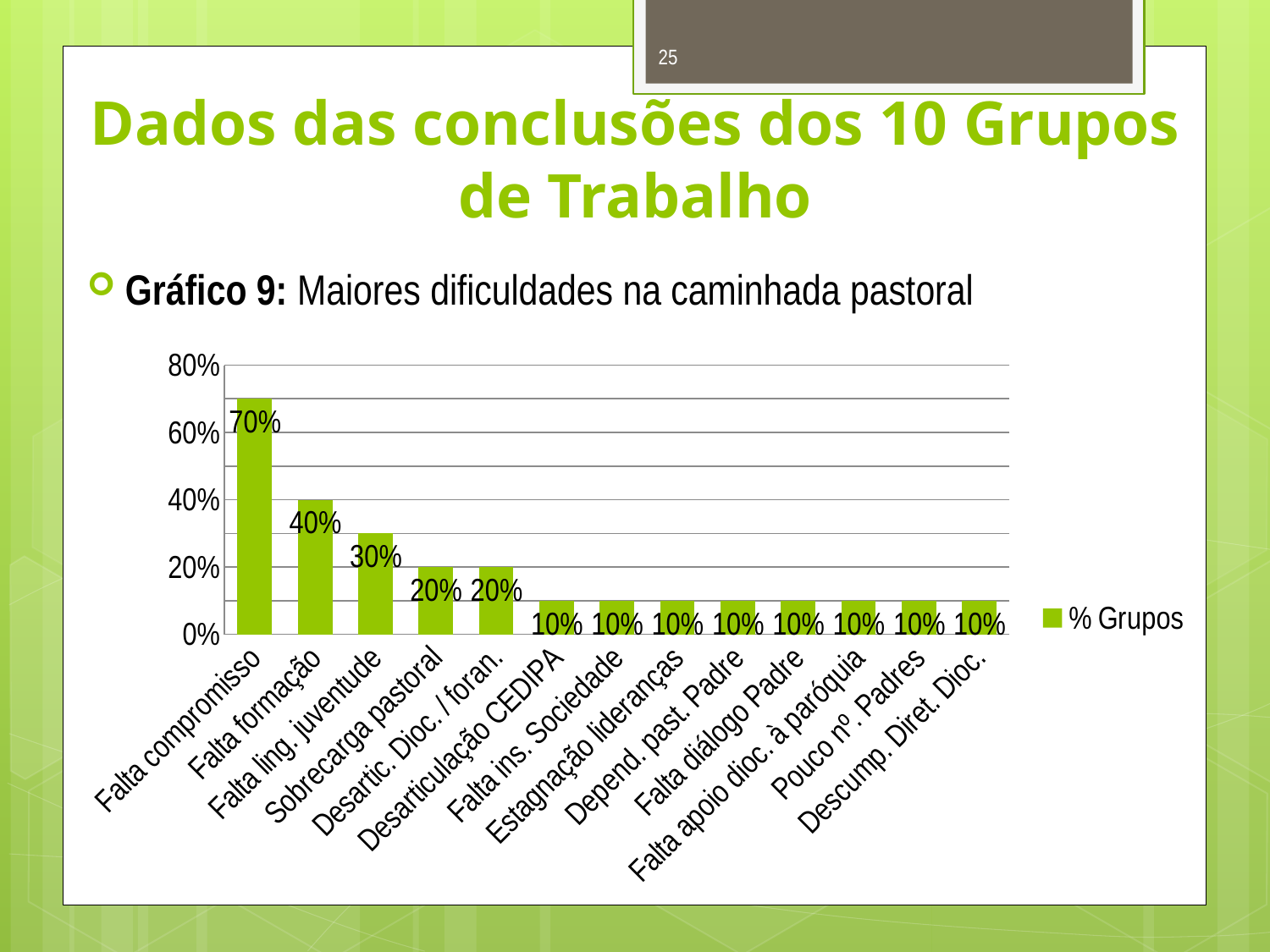
How many series does the legend list? 1 What is the value for Sobrecarga pastoral? 20% What is the value for Pouco nº. Padres? 10% What is the difference between the values for Falta compromisso and Falta formação? 30% What is the difference between the values for Falta ling. juventude and Desarticulação CEDIPA? 20% Which category has the highest value? Falta compromisso What is the value for Falta ling. juventude? 30% What kind of chart is shown on the slide? Bar chart What is the value for Falta compromisso? 70% Which is larger, the value for Falta formação or the value for Desartic. Dioc. / foran.? Falta formação How many categories are shown in the chart? 13 What is the value for Falta formação? 40%